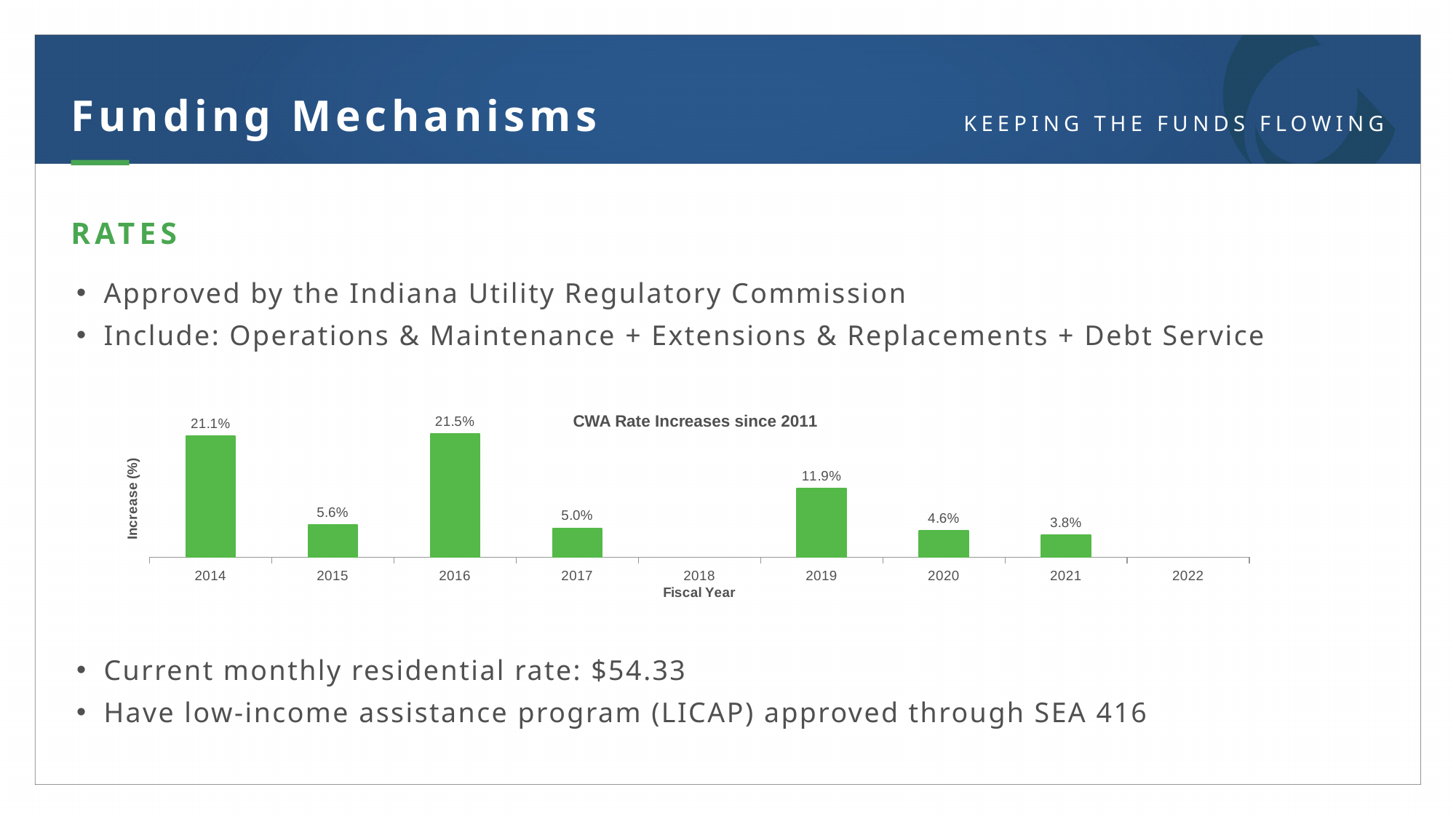
What type of chart is used to show CWA rate increases? Bar chart What is the difference between the rate increases for 2019 and 2020? 7.3% What is the title of the chart? CWA Rate Increases since 2011 How many fiscal years are shown on the x axis of the chart? 9 What is the rate increase shown for fiscal year 2016? 21.5% What is the rate increase shown for fiscal year 2021? 3.8% Do the rate increases rise or fall from 2019 to 2021? Fall What is the rate increase shown for fiscal year 2019? 11.9% What is the difference between the rate increases for 2016 and 2014? 0.4% Which fiscal year with a labelled bar has the lowest rate increase? 2021 Which fiscal year has the highest rate increase? 2016 Which fiscal year has the larger rate increase, 2015 or 2017? 2015